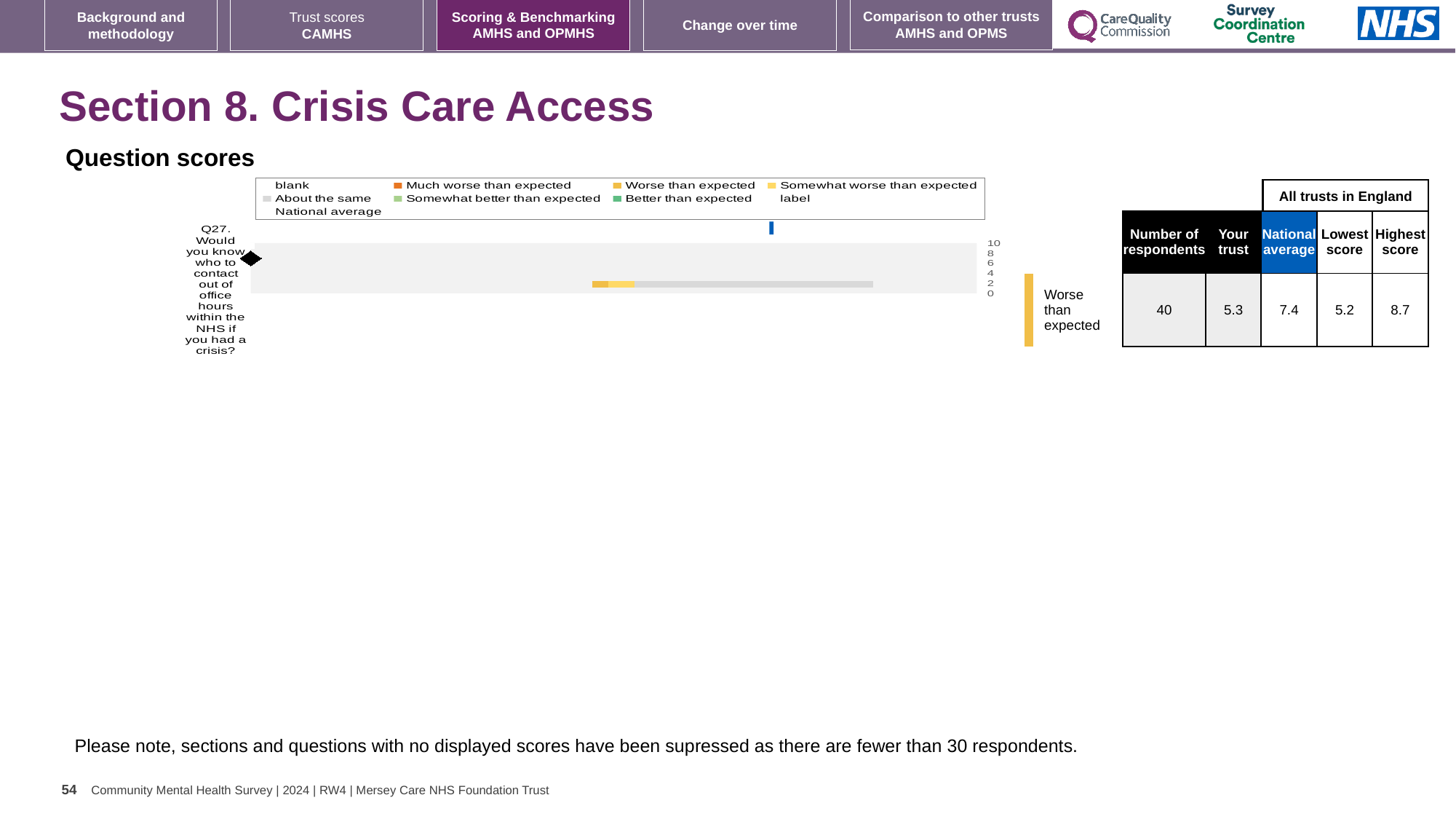
What kind of chart is used to show the question scores on this slide? bar chart According to the table beside the chart, what is the national average score for Q27? 7.4 For Q27, what is the difference between the highest score (8.7) and the lowest score (5.2) among all trusts in England? 3.5 For Q27, which is larger: the trust's score or the national average? the national average What benchmark category label is shown beside the bar for Q27? Worse than expected How many questions (categories) are plotted in the question scores chart? 1 For Q27, what is the difference between the national average (7.4) and the trust's score (5.3)? 2.1 According to the table beside the chart, what is the highest score among all trusts in England for Q27? 8.7 Which question number is plotted in the question scores chart? Q27 According to the table beside the chart, how many respondents answered Q27? 40 According to the table beside the chart, what is the 'Your trust' score for Q27? 5.3 According to the table beside the chart, what is the lowest score among all trusts in England for Q27? 5.2